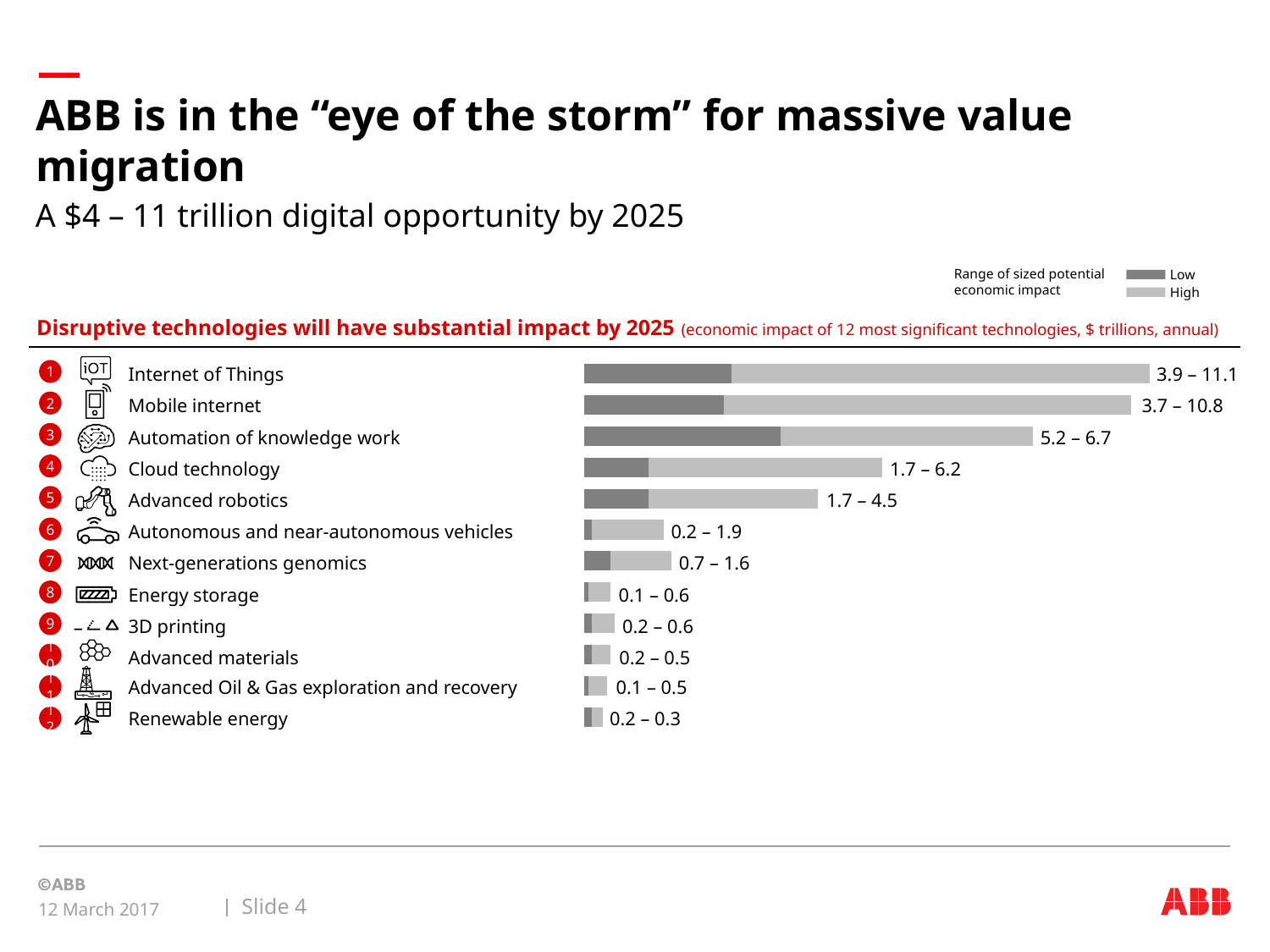
Which technology has the highest high estimate of economic impact? Internet of Things What range of economic impact is printed for Internet of Things? 3.9 – 11.1 What kind of chart is shown on the slide? Bar chart How many technologies are listed in the chart? 12 What is the high estimate printed for Advanced robotics? 4.5 Which technology has the lowest high estimate of economic impact? Renewable energy How many series does the legend list? 2 Which technology has the highest low estimate of economic impact? Automation of knowledge work What is the low estimate printed for Next-generations genomics? 0.7 Which has a larger high estimate, Cloud technology or Advanced robotics? Cloud technology What range of economic impact is printed for Cloud technology? 1.7 – 6.2 What is the difference between the high and low estimates for Internet of Things? 7.2